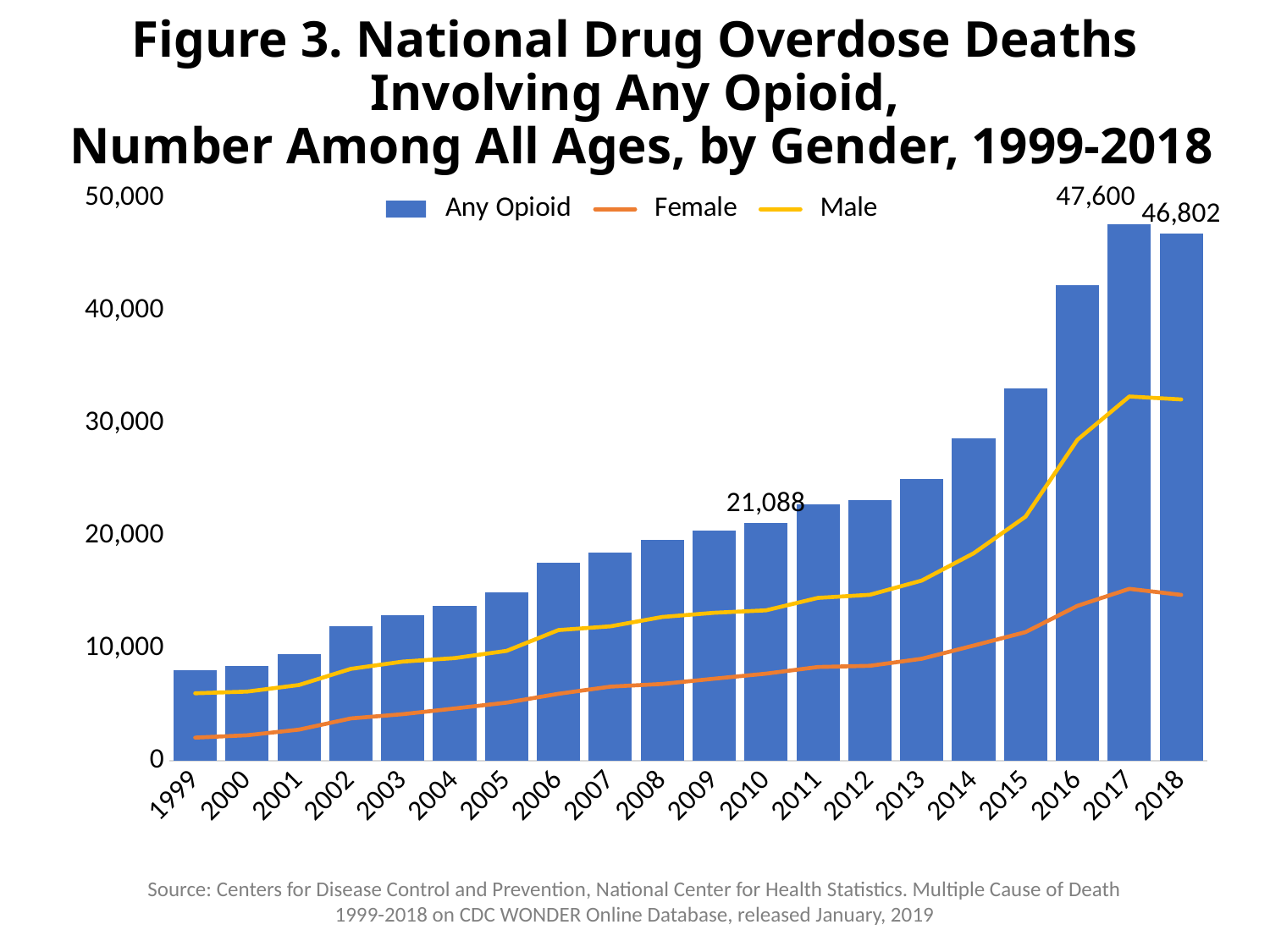
In 2018, which line is higher, Male or Female? Male Is the Any Opioid value for 1999 greater or less than 10,000? less Which is larger, the Any Opioid value for 2017 or for 2018? 2017 How many series does the legend list? 3 Is the Any Opioid value for 2016 greater or less than 40,000? greater What is the value of the Any Opioid bar for 2017? 47,600 Which year has the highest Any Opioid bar? 2017 Which year has the lowest Any Opioid bar? 1999 What is the value of the Any Opioid bar for 2018? 46,802 How many years are shown on the x axis? 20 What is the value of the Any Opioid bar for 2010? 21,088 What is the difference between the Any Opioid values for 2017 and 2018? 798